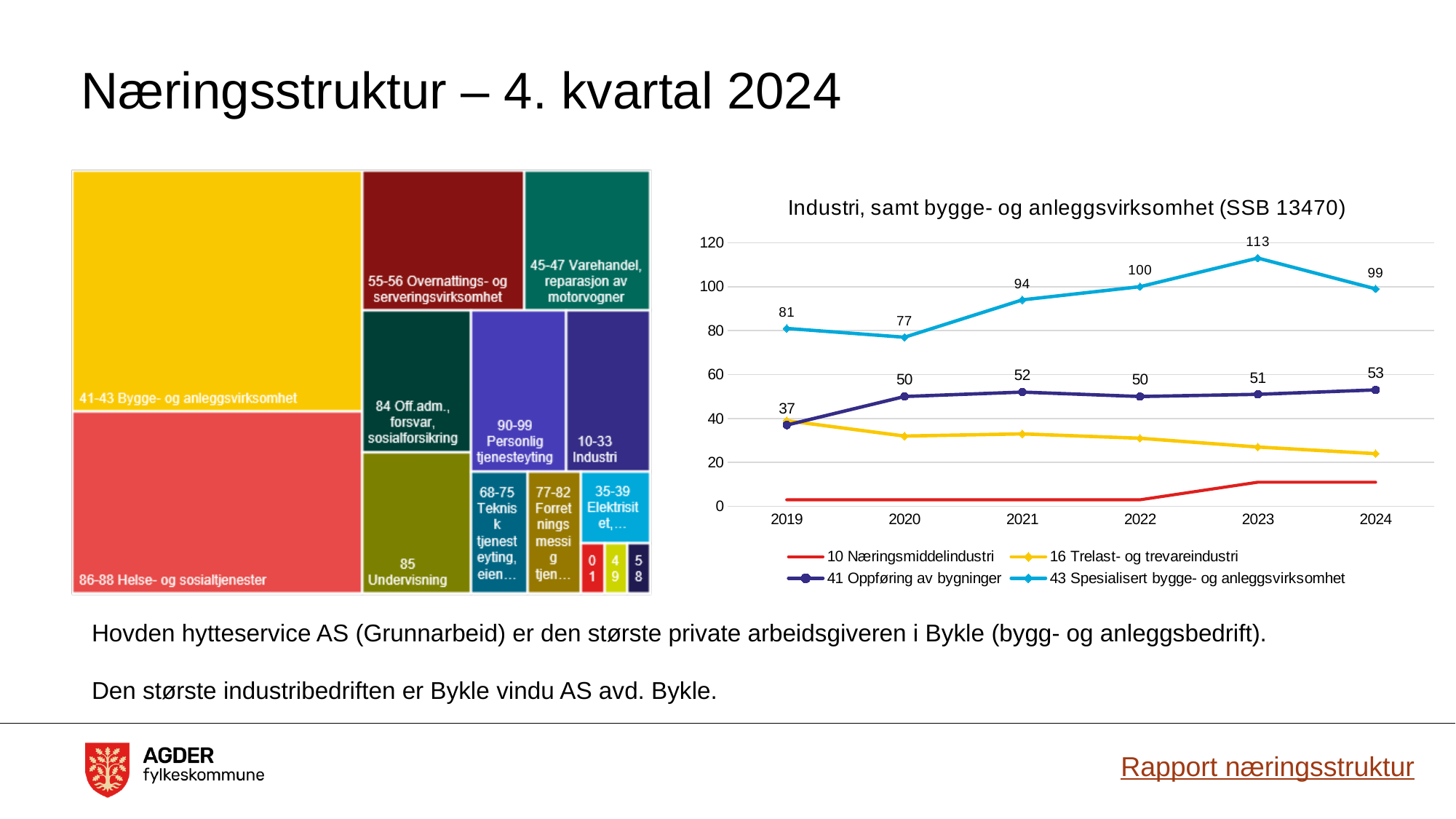
In the line chart 'Industri, samt bygge- og anleggsvirksomhet (SSB 13470)', what is the difference between the 2023 and 2024 values for 43 Spesialisert bygge- og anleggsvirksomhet? 14 In the line chart 'Industri, samt bygge- og anleggsvirksomhet (SSB 13470)', what is the value for 43 Spesialisert bygge- og anleggsvirksomhet in 2023? 113 In the line chart 'Industri, samt bygge- og anleggsvirksomhet (SSB 13470)', how many years are shown on the x axis? 6 In the line chart 'Industri, samt bygge- og anleggsvirksomhet (SSB 13470)', what is the value for 41 Oppføring av bygninger in 2019? 37 In the line chart 'Industri, samt bygge- og anleggsvirksomhet (SSB 13470)', what is the value for 43 Spesialisert bygge- og anleggsvirksomhet in 2024? 99 What kind of chart is the chart on the right of the slide? Line chart In the line chart 'Industri, samt bygge- og anleggsvirksomhet (SSB 13470)', is the value for 16 Trelast- og trevareindustri in 2024 greater or less than 40? less In the line chart 'Industri, samt bygge- og anleggsvirksomhet (SSB 13470)', in which year does 43 Spesialisert bygge- og anleggsvirksomhet reach its highest value? 2023 In the line chart 'Industri, samt bygge- og anleggsvirksomhet (SSB 13470)', in which year is the value for 41 Oppføring av bygninger lowest? 2019 In the line chart 'Industri, samt bygge- og anleggsvirksomhet (SSB 13470)', does the value for 16 Trelast- og trevareindustri rise or fall from 2019 to 2024? Fall In the line chart 'Industri, samt bygge- og anleggsvirksomhet (SSB 13470)', how many series does the legend list? 4 In the line chart 'Industri, samt bygge- og anleggsvirksomhet (SSB 13470)', which series has the higher value in 2022: 41 Oppføring av bygninger or 43 Spesialisert bygge- og anleggsvirksomhet? 43 Spesialisert bygge- og anleggsvirksomhet